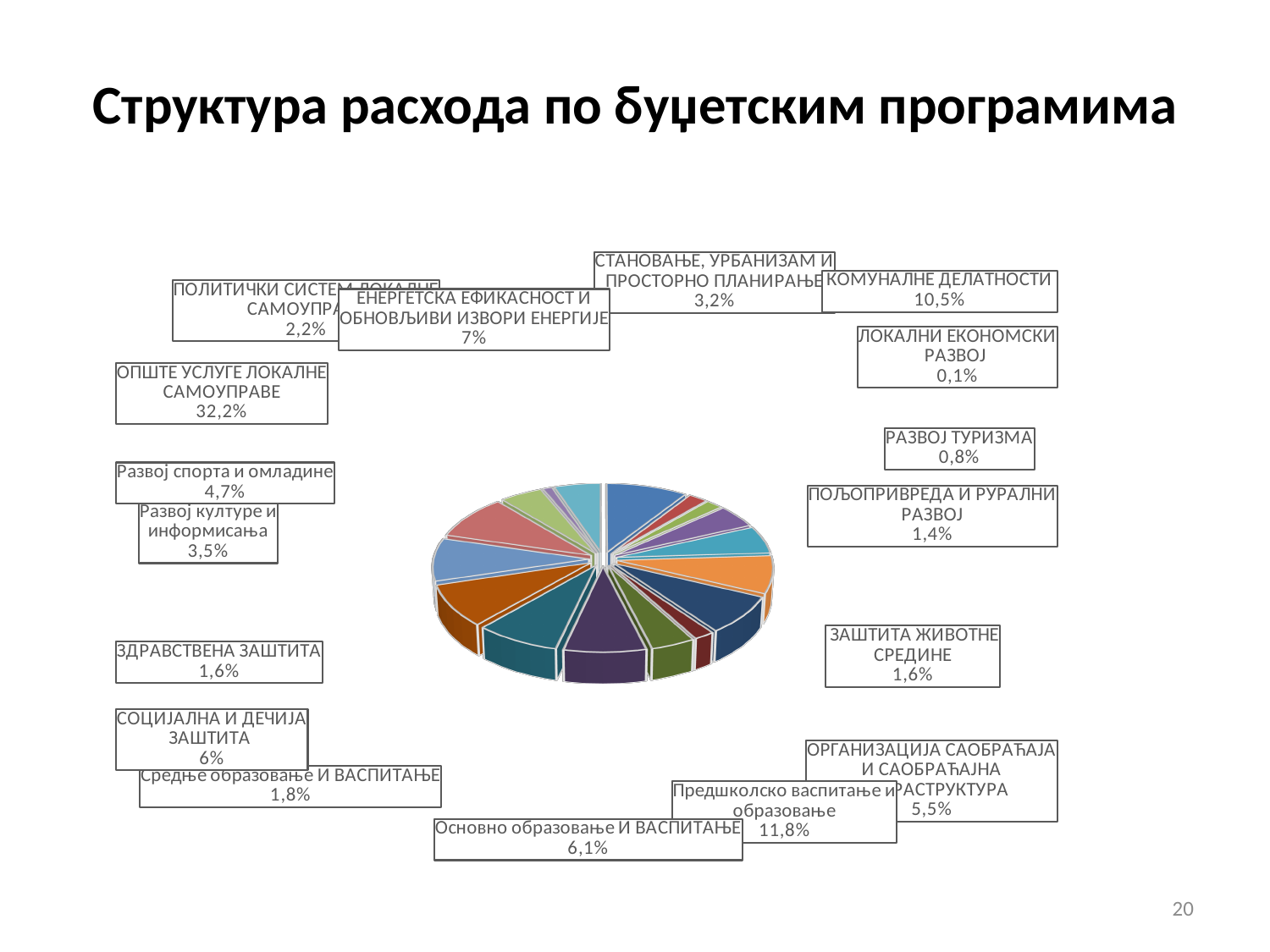
What share of expenditure goes to РАЗВОЈ ТУРИЗМА? 0,8% What is the difference in percentage points between ОПШТЕ УСЛУГЕ ЛОКАЛНЕ САМОУПРАВЕ and Предшколско васпитање и образовање? 20,4 What share of expenditure goes to ЕНЕРГЕТСКА ЕФИКАСНОСТ И ОБНОВЉИВИ ИЗВОРИ ЕНЕРГИЈЕ? 7% Which budget programme has the smallest share of expenditure? ЛОКАЛНИ ЕКОНОМСКИ РАЗВОЈ What kind of chart is shown on the slide? pie chart What share of expenditure goes to ОРГАНИЗАЦИЈА САОБРАЋАЈА И САОБРАЋАЈНА ИНФРАСТРУКТУРА? 5,5% Which has a larger share: Основно образовање И ВАСПИТАЊЕ or Средње образовање И ВАСПИТАЊЕ? Основно образовање И ВАСПИТАЊЕ What share of expenditure goes to КОМУНАЛНЕ ДЕЛАТНОСТИ? 10,5% What share of expenditure goes to Предшколско васпитање и образовање? 11,8% How many budget programmes are shown as slices in the pie chart? 17 What is the title of the chart on the slide? Структура расхода по буџетским програмима Which budget programme has the largest share of expenditure? ОПШТЕ УСЛУГЕ ЛОКАЛНЕ САМОУПРАВЕ